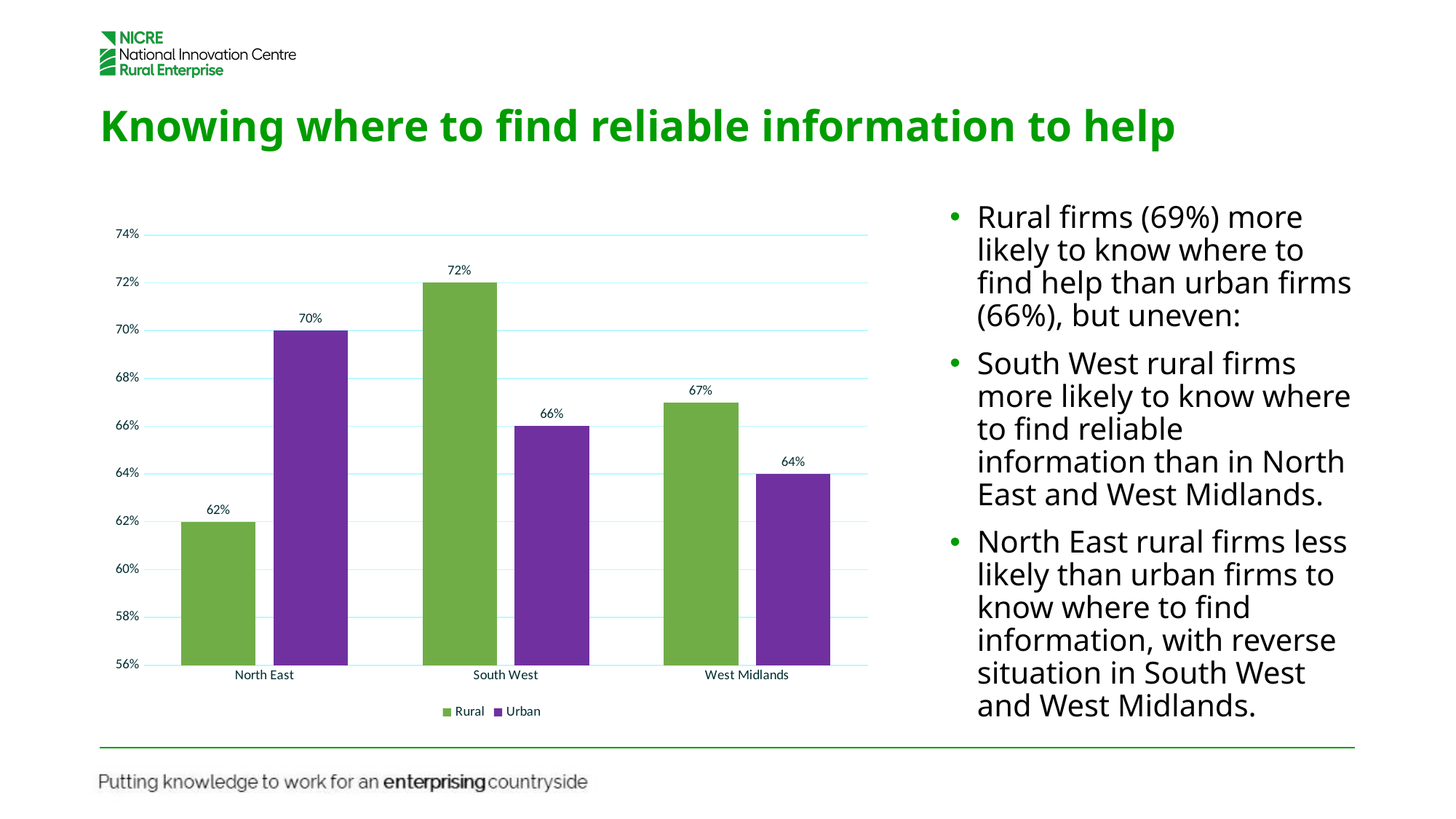
Which region has the highest Rural value? South West What is the difference between the Rural and Urban values for North East? 8% What colour are the Urban bars? purple Is the Rural value for North East greater or less than 64%? less What is the Urban value for North East? 70% What kind of chart is shown on the slide? bar chart What is the Rural value for South West? 72% How many regions are shown on the x axis? 3 Which is larger for West Midlands, the Rural value or the Urban value? Rural Which region has the lowest Urban value? West Midlands How many series does the legend list? 2 What is the Urban value for West Midlands? 64%